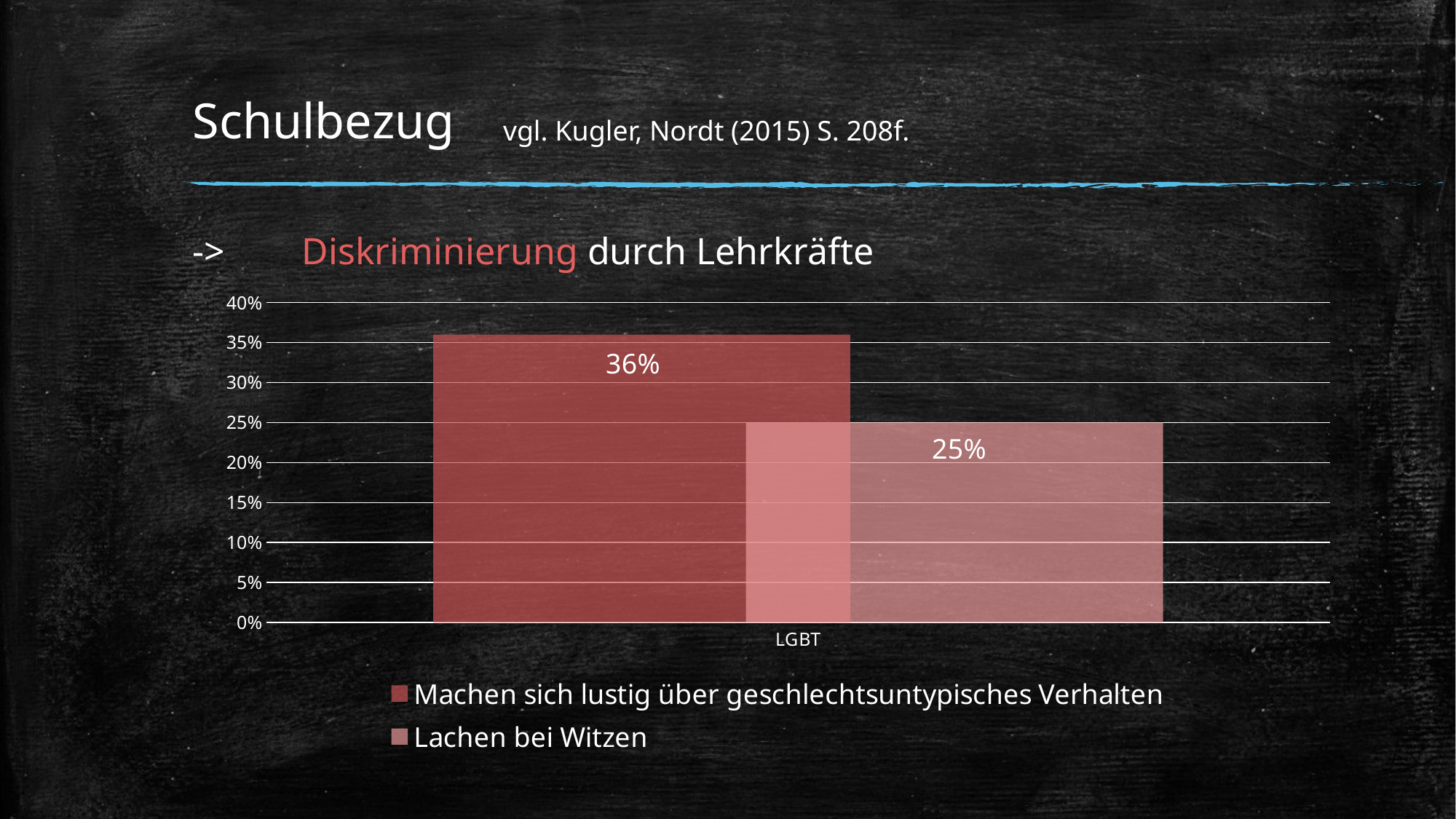
Which series has the lowest value on the chart? Lachen bei Witzen What is the value for "Machen sich lustig über geschlechtsuntypisches Verhalten" in the LGBT category? 36% Is the value for "Machen sich lustig über geschlechtsuntypisches Verhalten" greater or less than 35%? greater How many series does the legend list? 2 What is the label of the category on the x axis? LGBT What is the difference between the values for "Machen sich lustig über geschlechtsuntypisches Verhalten" and "Lachen bei Witzen"? 11% What kind of chart is shown on the slide? bar chart What is the maximum value shown on the y axis? 40% Is the value for "Lachen bei Witzen" greater or less than 30%? less What is the value for "Lachen bei Witzen" in the LGBT category? 25% Which series has the higher value: "Machen sich lustig über geschlechtsuntypisches Verhalten" or "Lachen bei Witzen"? Machen sich lustig über geschlechtsuntypisches Verhalten How many categories are shown on the x axis? 1